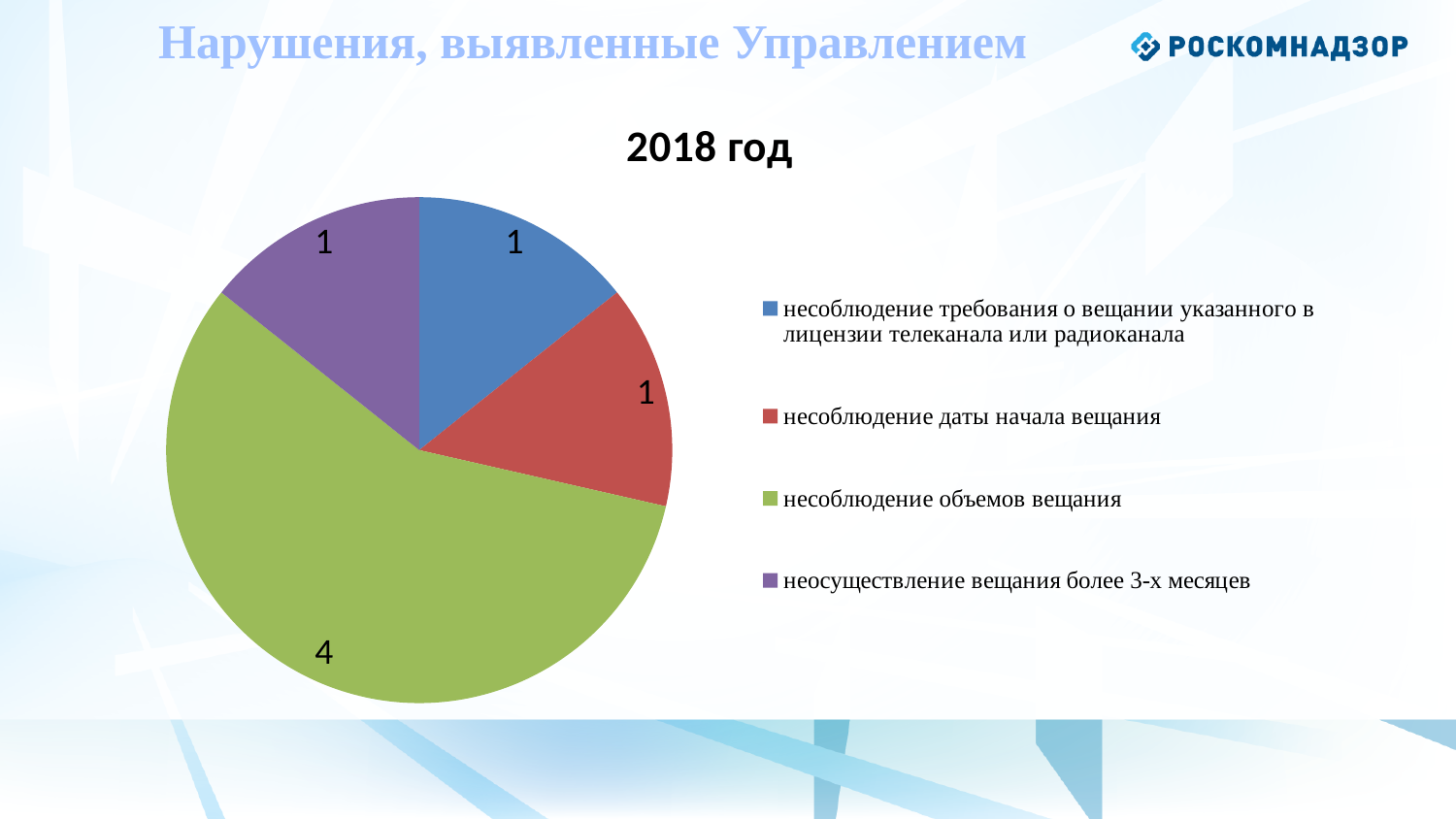
What is the value for "несоблюдение даты начала вещания"? 1 How many categories does the pie chart have? 4 What is the difference between the value for "несоблюдение объемов вещания" and the value for "неосуществление вещания более 3-х месяцев"? 3 Which is larger: "несоблюдение объемов вещания" or "несоблюдение даты начала вещания"? несоблюдение объемов вещания What colour is the slice for "несоблюдение объемов вещания"? green What is the value for "неосуществление вещания более 3-х месяцев"? 1 What is the title of the chart? 2018 год What is the value for "несоблюдение требования о вещании указанного в лицензии телеканала или радиоканала"? 1 Which category has the highest value? несоблюдение объемов вещания What kind of chart is shown on the slide? pie chart What is the value for "несоблюдение объемов вещания"? 4 What is the total of all slices in the pie chart? 7